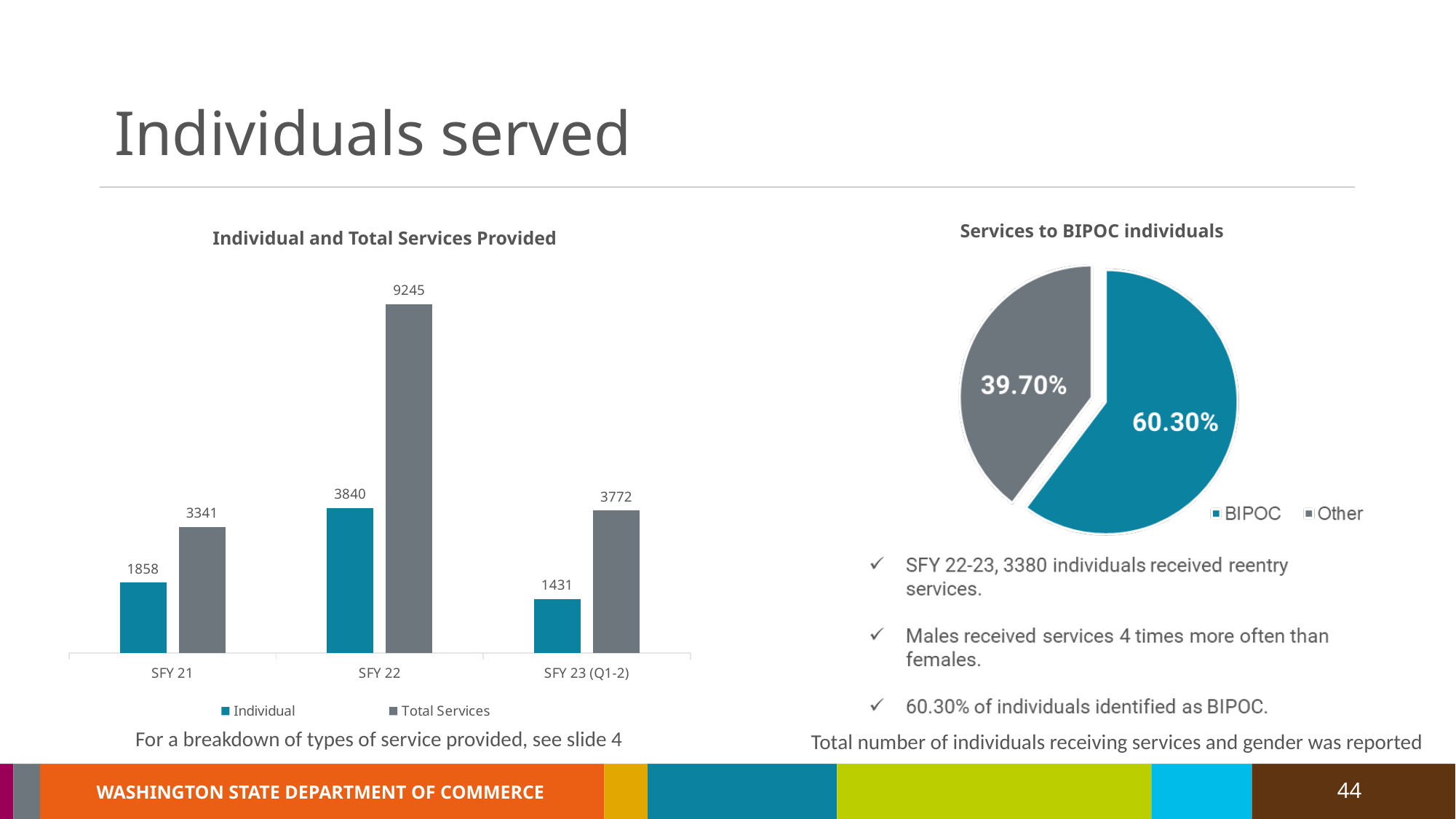
In the 'Individual and Total Services Provided' chart, is the Total Services value larger for SFY 21 or SFY 23 (Q1-2)? SFY 23 (Q1-2) How many series does the legend of the 'Individual and Total Services Provided' chart list? 2 In the 'Individual and Total Services Provided' chart, which category has the lowest Individual value? SFY 23 (Q1-2) In the 'Individual and Total Services Provided' chart, what is the Total Services value for SFY 22? 9245 In the 'Individual and Total Services Provided' chart, which category has the highest Total Services value? SFY 22 In the 'Services to BIPOC individuals' pie chart, what share is BIPOC? 60.30% In the 'Individual and Total Services Provided' chart, what is the difference between Total Services and Individual for SFY 22? 5405 What kind of chart is 'Individual and Total Services Provided'? Bar chart In the 'Individual and Total Services Provided' chart, what is the Individual value for SFY 21? 1858 In the 'Services to BIPOC individuals' pie chart, which slice is larger, BIPOC or Other? BIPOC How many categories are shown on the x axis of the 'Individual and Total Services Provided' chart? 3 In the 'Individual and Total Services Provided' chart, what is the Individual value for SFY 23 (Q1-2)? 1431